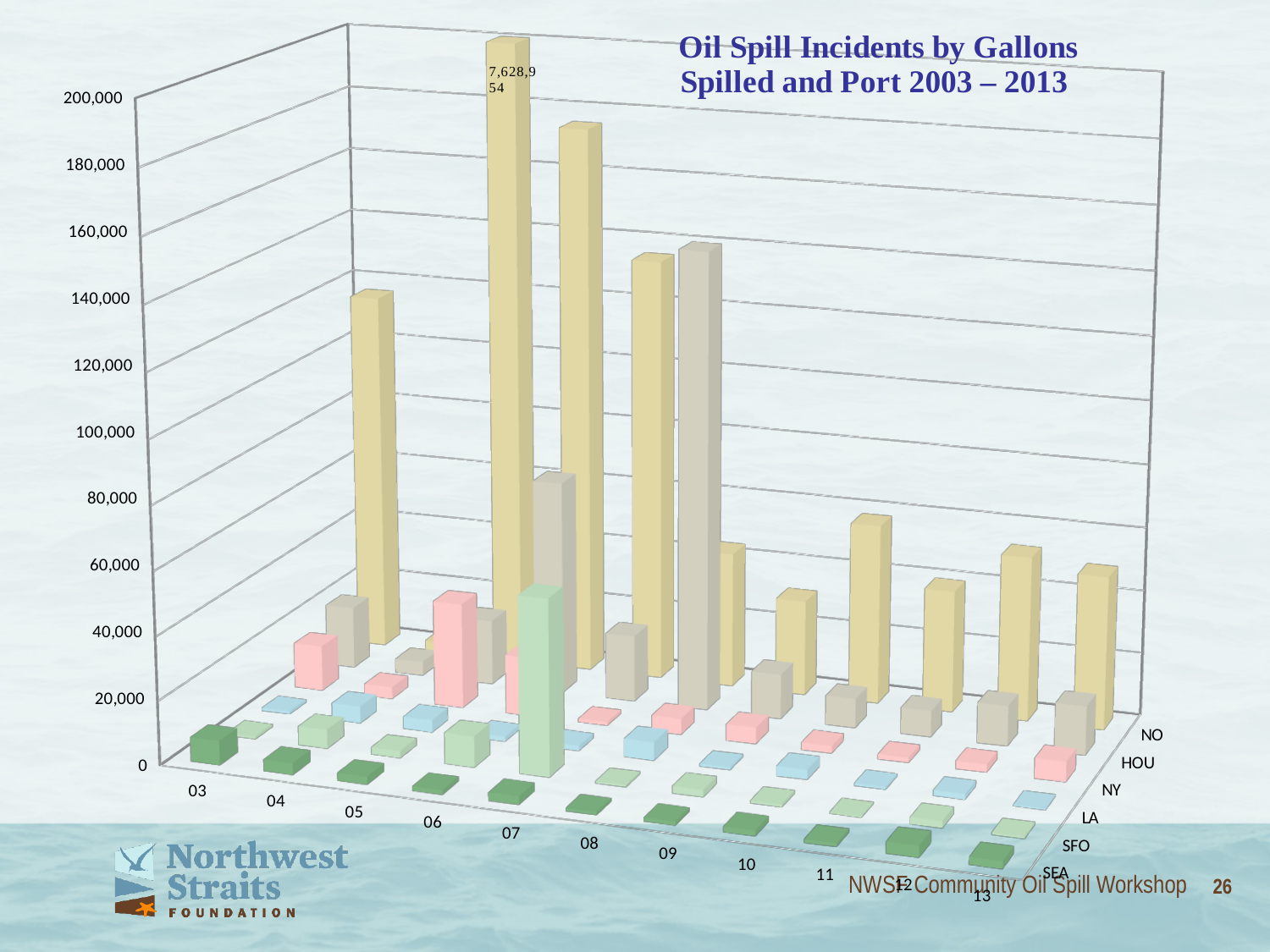
What kind of chart is shown on the slide? bar chart Is the value for SEA in 03 greater or less than 20,000? less How many ports are listed along the depth axis of the chart? 6 Which port is listed first (nearest the front) on the depth axis of the chart? SEA How many years are shown along the x axis of the chart? 11 In which year does the tallest bar in the chart occur? 05 Which is larger in 07: the bar for NO or the bar for SEA? NO Is the value for NO in 07 greater or less than 200,000? less Which port has the tallest bar in the chart? NO What is the highest value shown on the vertical axis of the chart? 200,000 What is the title of the chart? Oil Spill Incidents by Gallons Spilled and Port 2003 – 2013